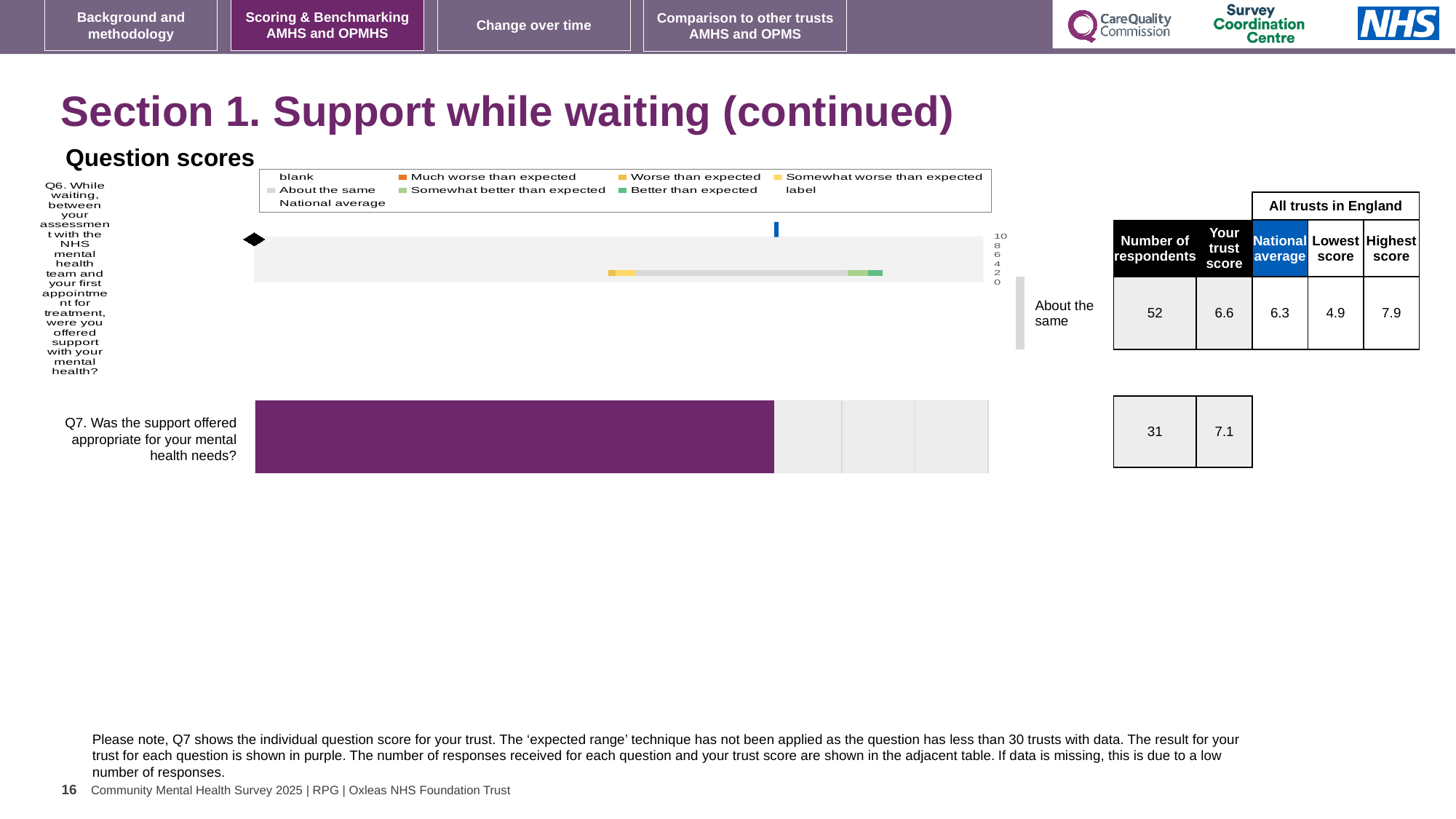
What is the lowest score among all trusts in England for Q6? 4.9 What is the difference between the highest and lowest scores for Q6 across all trusts in England? 3.0 What kind of chart is used to show the question scores on this slide? bar chart What is the national average score for Q6? 6.3 How many respondents answered Q7? 31 What is the trust score for Q6 shown in the table next to the chart? 6.6 Which expected-range category is the trust's Q6 score placed in? About the same Is the value of the purple bar for Q7 greater or less than 6? greater Is the trust score for Q6 higher or lower than the national average? higher What is the highest score among all trusts in England for Q6? 7.9 How many respondents answered Q6? 52 What is the trust score for Q7? 7.1